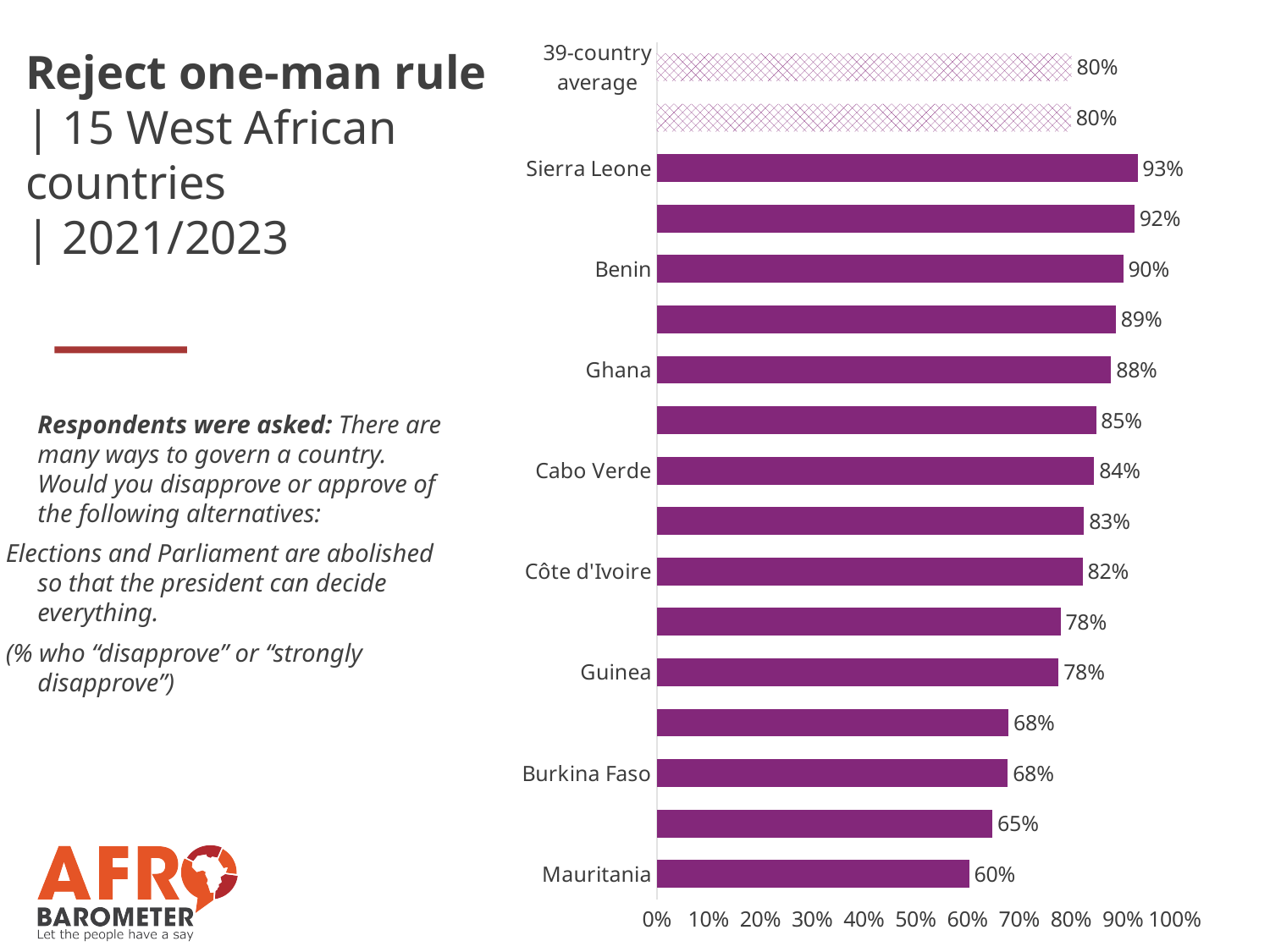
What kind of chart is shown on the slide? Bar chart What is the title of the chart on the slide? Reject one-man rule | 15 West African countries | 2021/2023 What is the difference in percentage points between Sierra Leone and Mauritania? 33 percentage points Which labelled country has the lowest share rejecting one-man rule? Mauritania Which has a higher value, Benin or Cabo Verde? Benin Which labelled country has the highest share rejecting one-man rule? Sierra Leone What percentage of respondents in Sierra Leone reject one-man rule? 93% What is the 39-country average for rejecting one-man rule? 80% What is the value shown for Ghana? 88% Is the value for Guinea greater or less than 80%? less What is the value shown for Mauritania? 60% What is the value shown for Côte d'Ivoire? 82%